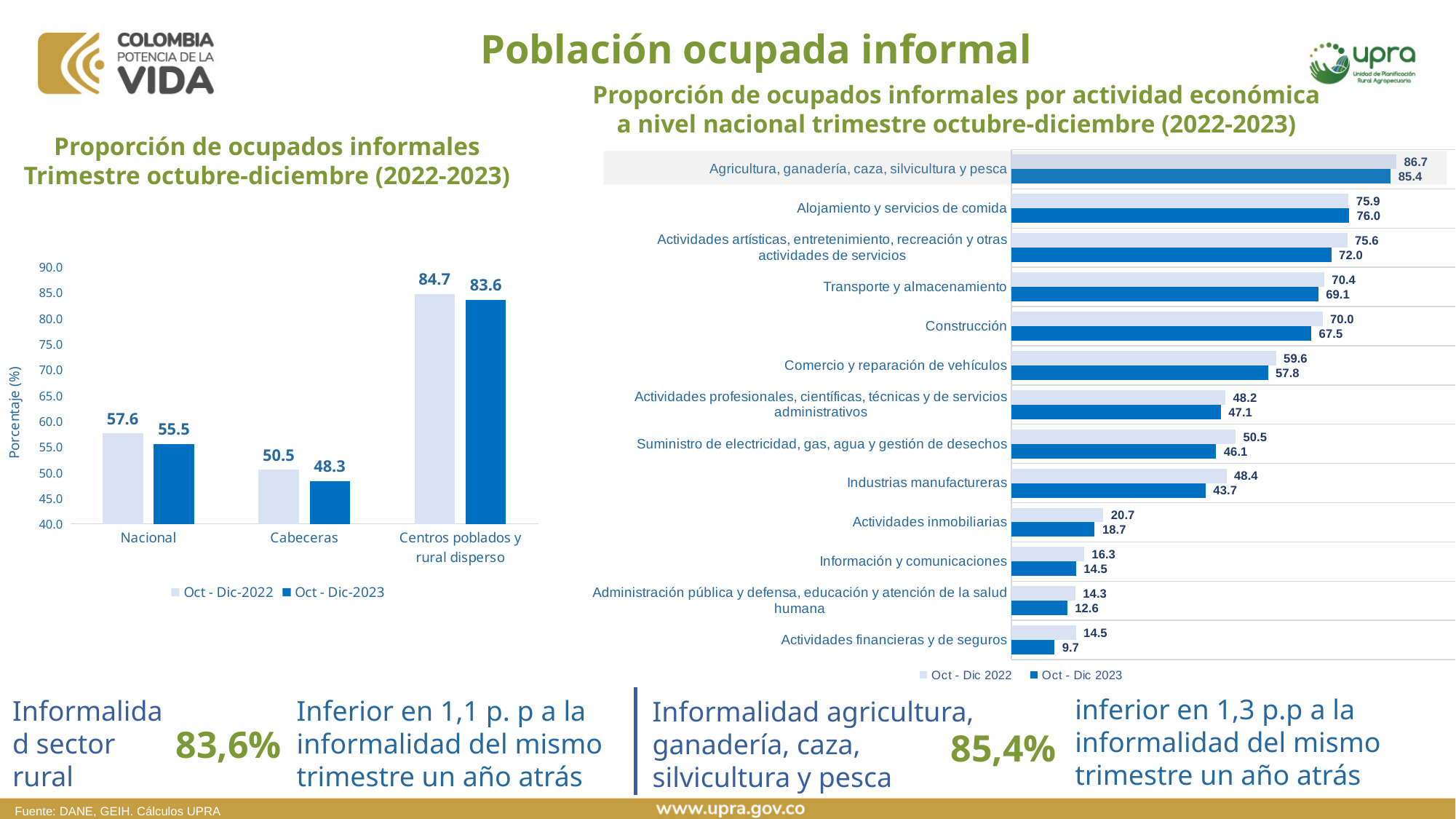
In the left chart (Proporción de ocupados informales, Trimestre octubre-diciembre), what is the value for Nacional in Oct - Dic-2023? 55.5 In the right chart (Proporción de ocupados informales por actividad económica), what is the Oct - Dic 2022 value for Industrias manufactureras? 48.4 In the left chart (Proporción de ocupados informales, Trimestre octubre-diciembre), how many categories are shown on the x axis? 3 What kind of chart is the right chart (Proporción de ocupados informales por actividad económica)? Bar chart In the left chart (Proporción de ocupados informales, Trimestre octubre-diciembre), what is the label of the y axis? Porcentaje (%) In the right chart (Proporción de ocupados informales por actividad económica), how many economic activities are listed? 13 In the left chart (Proporción de ocupados informales, Trimestre octubre-diciembre), which category has the highest value in Oct - Dic-2023? Centros poblados y rural disperso In the right chart (Proporción de ocupados informales por actividad económica), which is larger for Alojamiento y servicios de comida: the Oct - Dic 2022 value or the Oct - Dic 2023 value? Oct - Dic 2023 In the left chart (Proporción de ocupados informales, Trimestre octubre-diciembre), what is the value for Cabeceras in Oct - Dic-2022? 50.5 In the right chart (Proporción de ocupados informales por actividad económica), which activity has the lowest Oct - Dic 2023 value? Actividades financieras y de seguros In the right chart (Proporción de ocupados informales por actividad económica), what is the Oct - Dic 2023 value for Construcción? 67.5 In the left chart (Proporción de ocupados informales, Trimestre octubre-diciembre), what is the difference between the Oct - Dic-2022 and Oct - Dic-2023 values for Nacional? 2.1